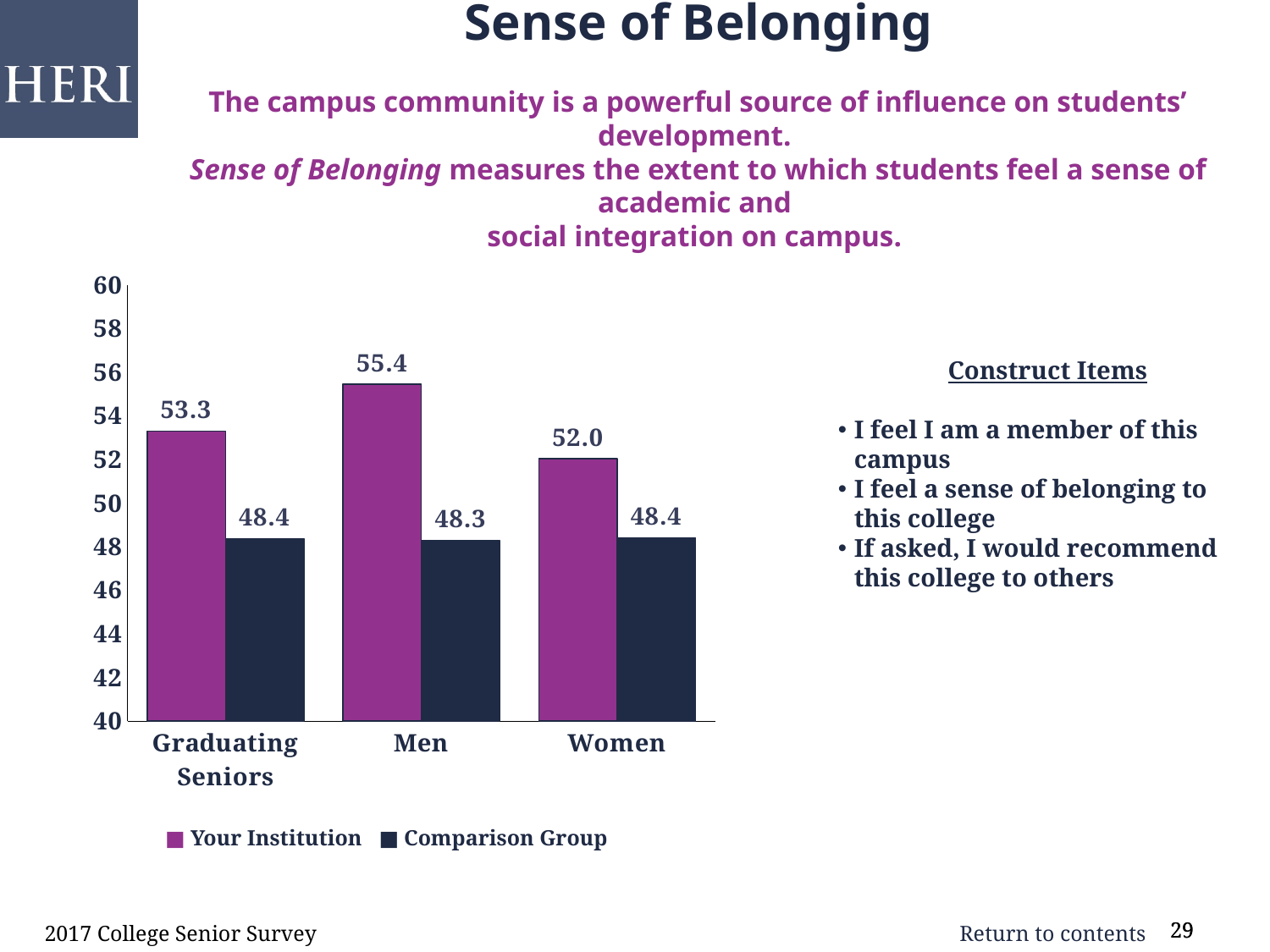
How many categories are shown on the x axis? 3 What is the Your Institution value for Women? 52.0 Which category has the highest Your Institution value? Men What kind of chart is shown on the slide? Bar chart What is the Comparison Group value for Men? 48.3 Which colour represents the Comparison Group series? Dark navy What is the difference between the Your Institution and Comparison Group values for Men? 7.1 Which category has the lowest Your Institution value? Women What is the Your Institution value for Men? 55.4 What is the Comparison Group value for Graduating Seniors? 48.4 Which is larger for Graduating Seniors: the Your Institution value or the Comparison Group value? Your Institution How many series does the legend list? 2